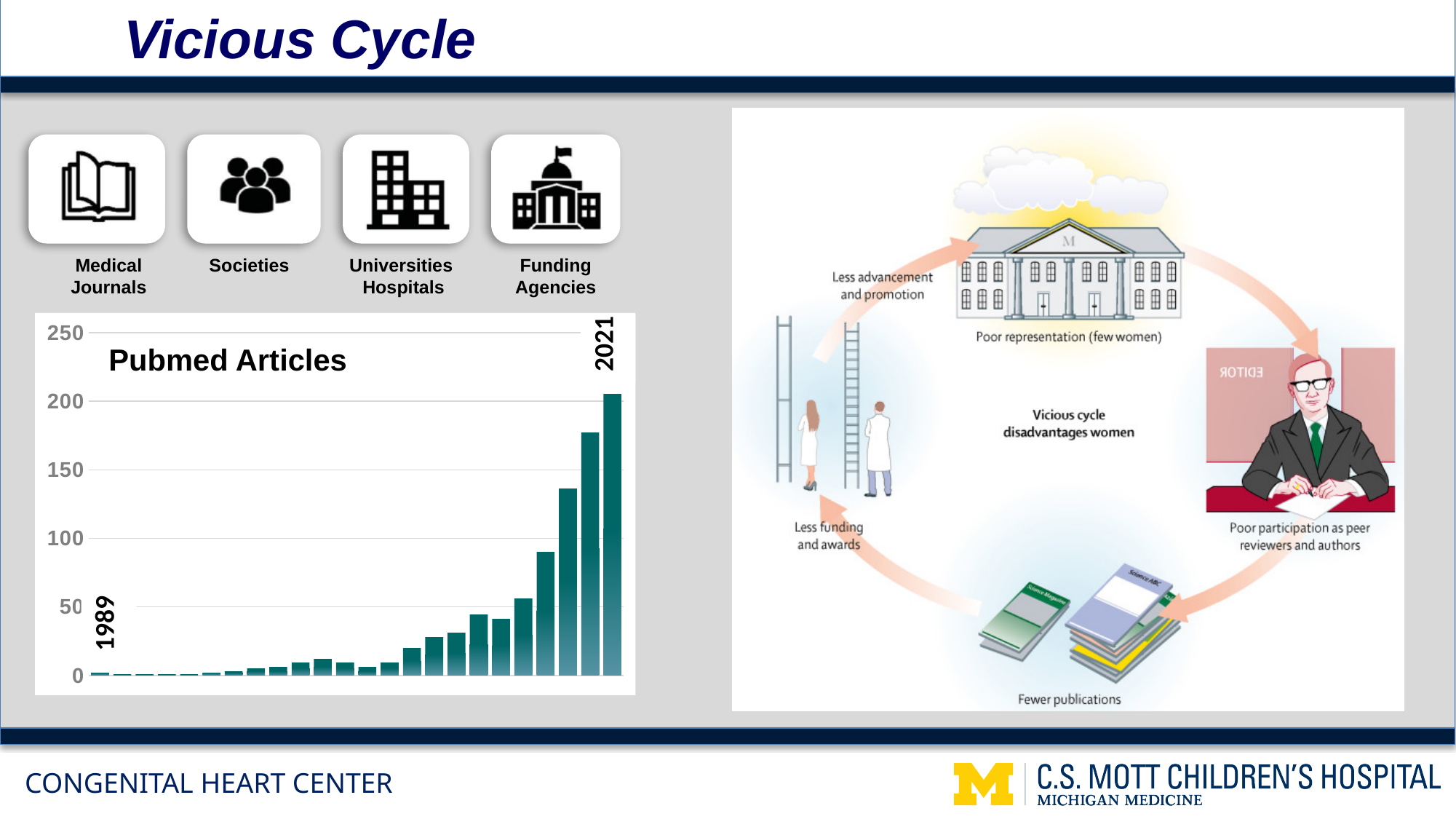
In the Pubmed Articles chart, is the value for 1989 greater or less than 50? less What is the highest value shown on the y axis of the Pubmed Articles chart? 250 In the Pubmed Articles chart, which is larger, the value for 1989 or the value for 2021? 2021 In the Pubmed Articles chart, is the value for 2021 greater or less than 150? greater What kind of chart is the Pubmed Articles chart? bar chart In the Pubmed Articles chart, do the values generally rise or fall from 1989 to 2021? rise What is the first year labeled on the x axis of the Pubmed Articles chart? 1989 In the Pubmed Articles chart, which year has the highest value? 2021 What is the title of the chart on the left of the slide? Pubmed Articles